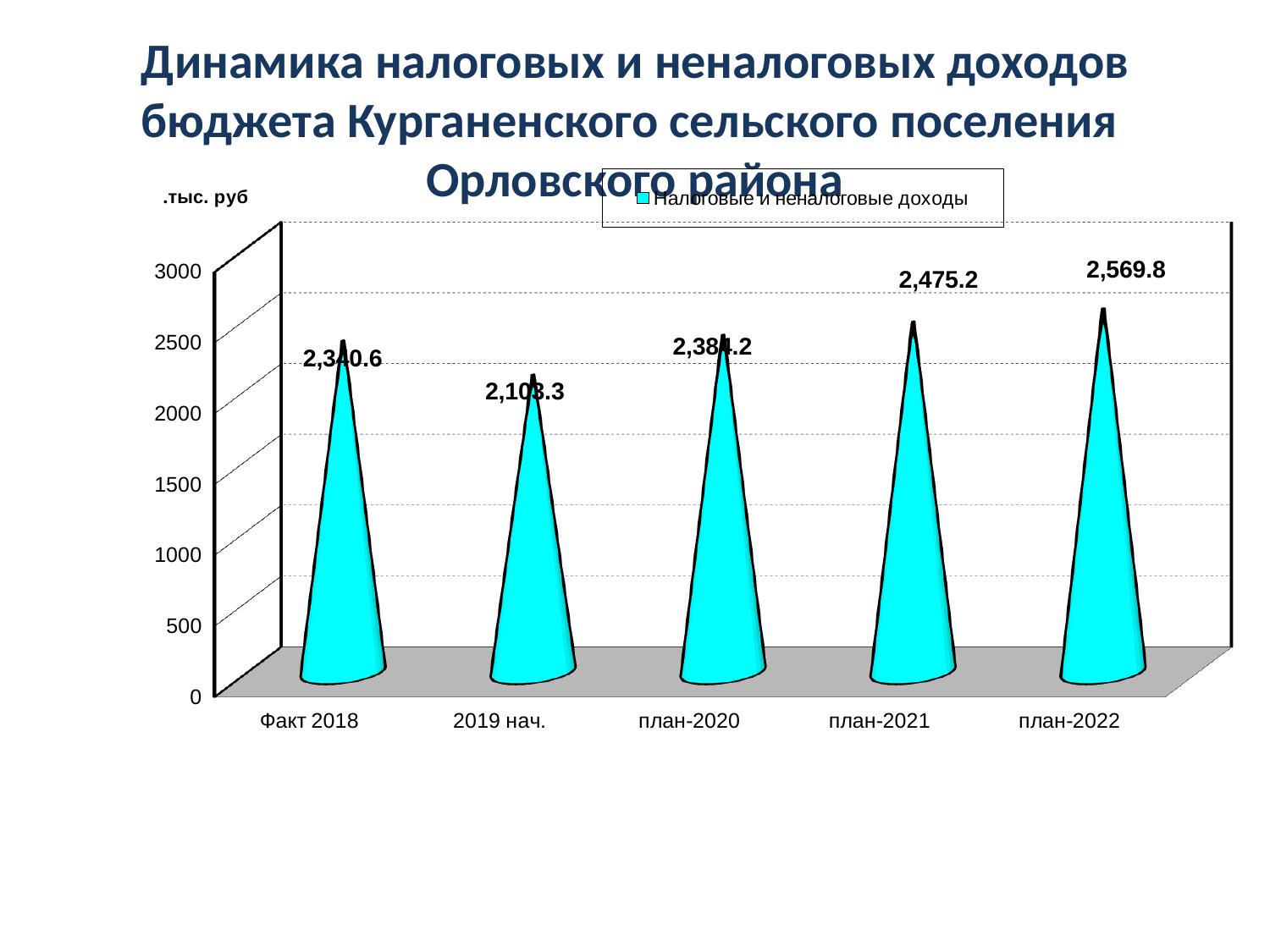
What is the difference between the values for план-2022 and план-2021? 94.6 Which category has the highest value? план-2022 How many categories are shown on the x axis? 5 Which is larger, the value for план-2021 or the value for план-2020? план-2021 What series name is shown in the legend? Налоговые и неналоговые доходы What is the value for план-2021? 2,475.2 Which category has the lowest value? 2019 нач. Is the value for Факт 2018 greater or less than 2500? less Is the value for план-2022 greater or less than 2500? greater What kind of chart is shown on the slide? bar chart How many series does the legend list? 1 What is the value for план-2022? 2,569.8